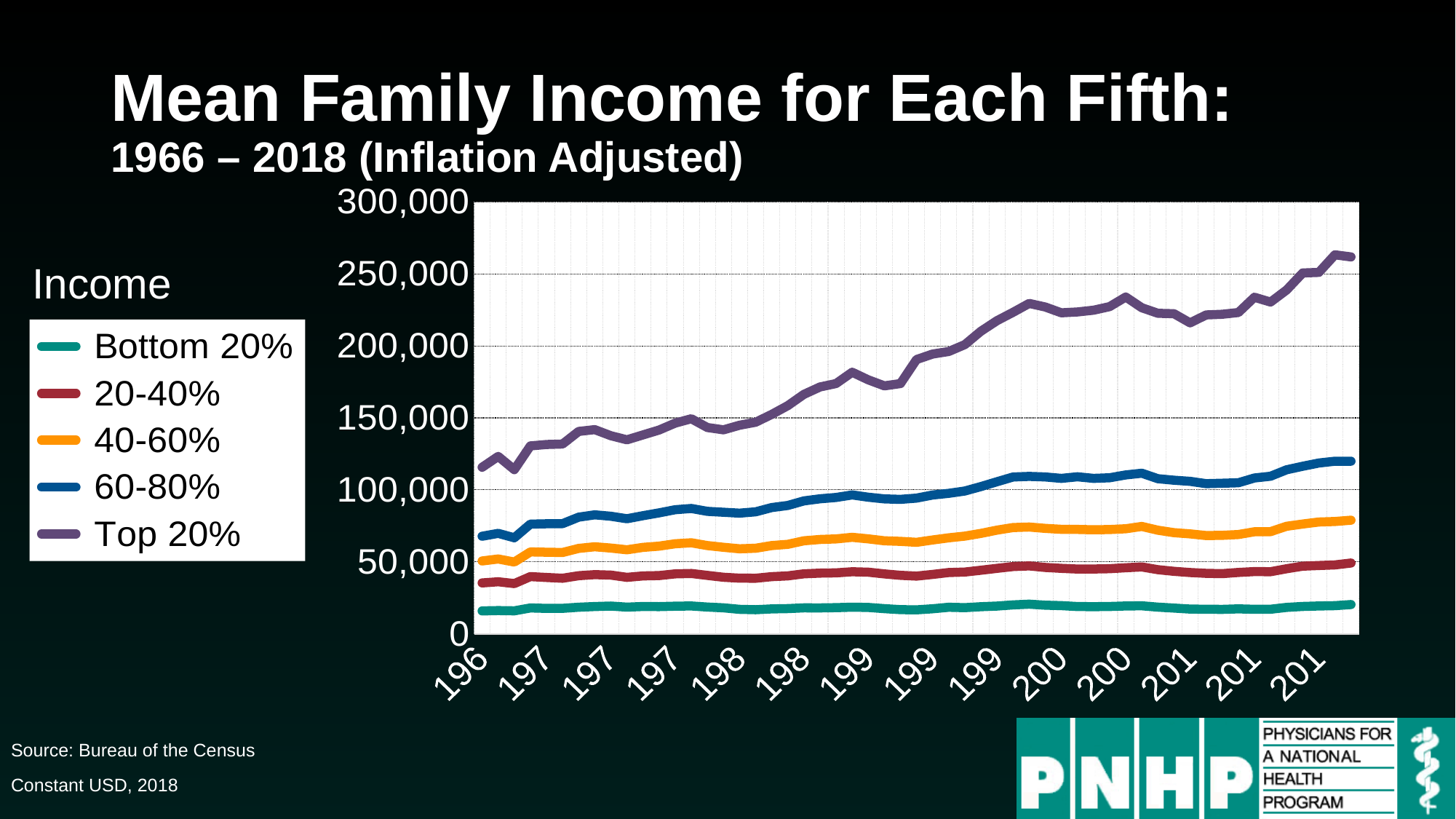
What kind of chart is shown on the slide? line chart What is the title of the chart? Mean Family Income for Each Fifth: 1966 – 2018 (Inflation Adjusted) Is the value for the Top 20% series at the right end of the chart greater or less than 250,000? greater Which series has the highest values throughout the chart? Top 20% Is the value for the 40-60% series at the right end of the chart greater or less than 100,000? less Which series has the lowest values throughout the chart? Bottom 20% At the right end of the chart, which series is larger: Top 20% or 60-80%? Top 20% Does the Top 20% series generally rise or fall from left to right across the chart? rise How many series does the legend list? 5 What is the highest value shown on the y axis? 300,000 Is the value for the 60-80% series at the right end of the chart greater or less than 100,000? greater